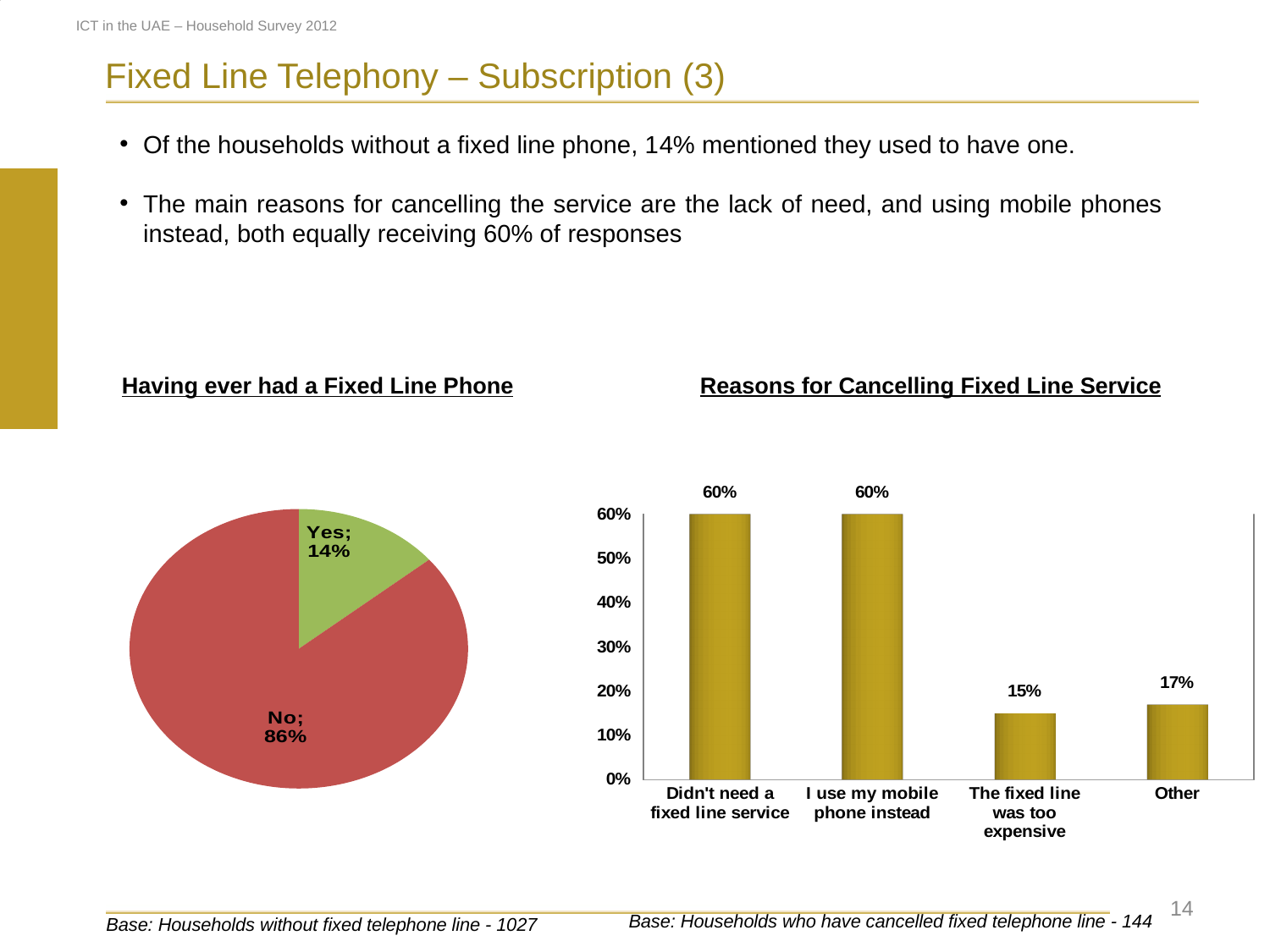
In the 'Having ever had a Fixed Line Phone' chart, what share of households answered Yes? 14% How many reasons are shown in the 'Reasons for Cancelling Fixed Line Service' chart? 4 What kind of chart is 'Having ever had a Fixed Line Phone'? Pie chart In the 'Reasons for Cancelling Fixed Line Service' chart, what is the value for 'Other'? 17% What kind of chart is 'Reasons for Cancelling Fixed Line Service'? Bar chart In the 'Reasons for Cancelling Fixed Line Service' chart, what is the value for 'I use my mobile phone instead'? 60% In the 'Having ever had a Fixed Line Phone' chart, which slice is larger, Yes or No? No In the 'Reasons for Cancelling Fixed Line Service' chart, which reason has the lowest value? The fixed line was too expensive In the 'Reasons for Cancelling Fixed Line Service' chart, what is the difference between 'Didn't need a fixed line service' and 'Other'? 43% In the 'Having ever had a Fixed Line Phone' chart, what share of households answered No? 86% In the 'Reasons for Cancelling Fixed Line Service' chart, which is larger, 'Other' or 'The fixed line was too expensive'? Other In the 'Reasons for Cancelling Fixed Line Service' chart, what is the value for 'The fixed line was too expensive'? 15%